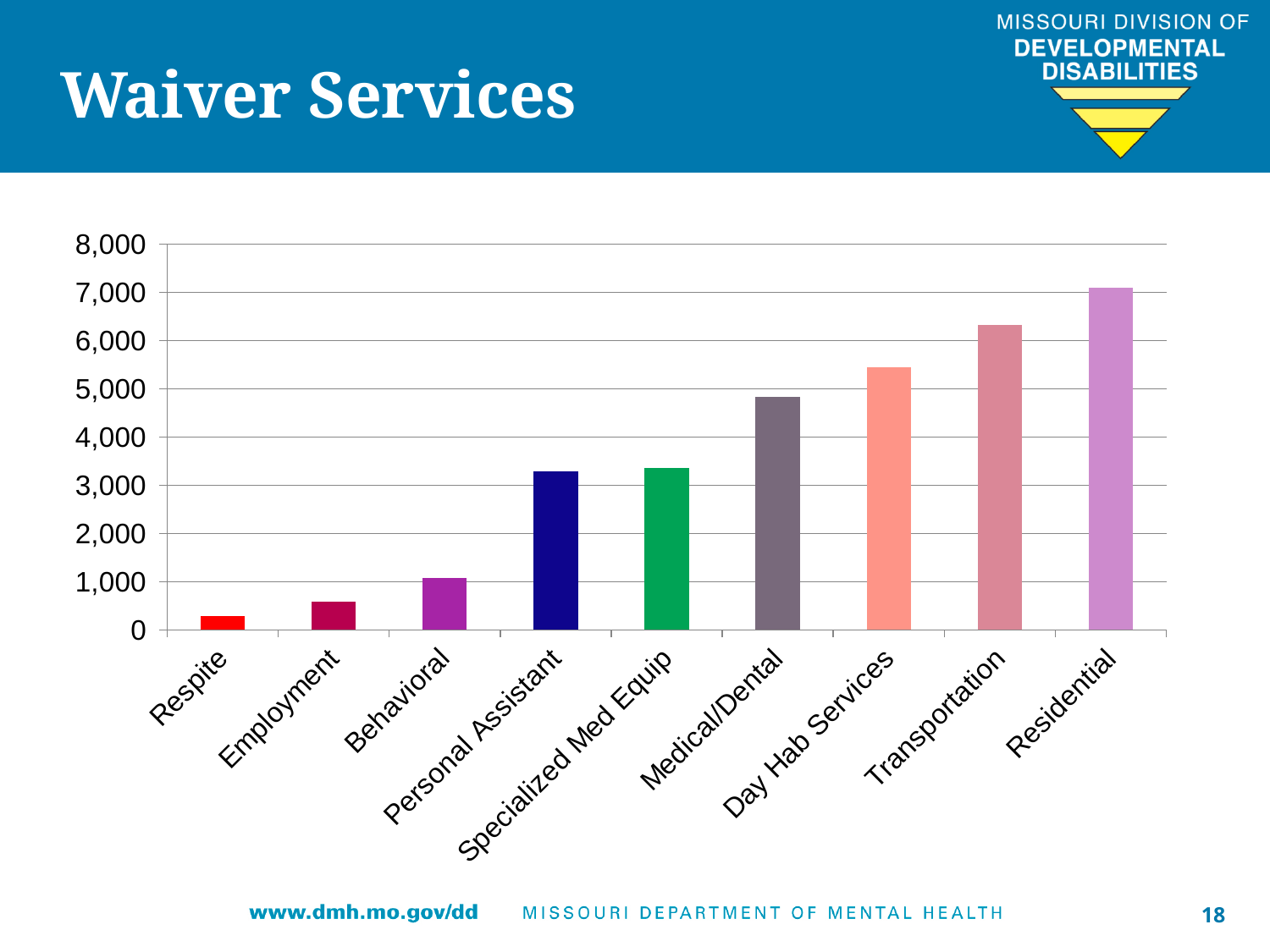
Which category has the lowest value in the chart? Respite What is the title of the slide containing the chart? Waiver Services Which is larger, the value for Day Hab Services or the value for Medical/Dental? Day Hab Services Is the value for Employment greater or less than 1,000? less Is the value for Medical/Dental greater or less than 5,000? less Which category has the highest value in the chart? Residential Is the value for Residential greater or less than 7,000? greater Do the values generally rise or fall moving from left to right along the x axis? rise What kind of chart is shown on the slide? bar chart How many categories are shown on the x axis of the chart? 9